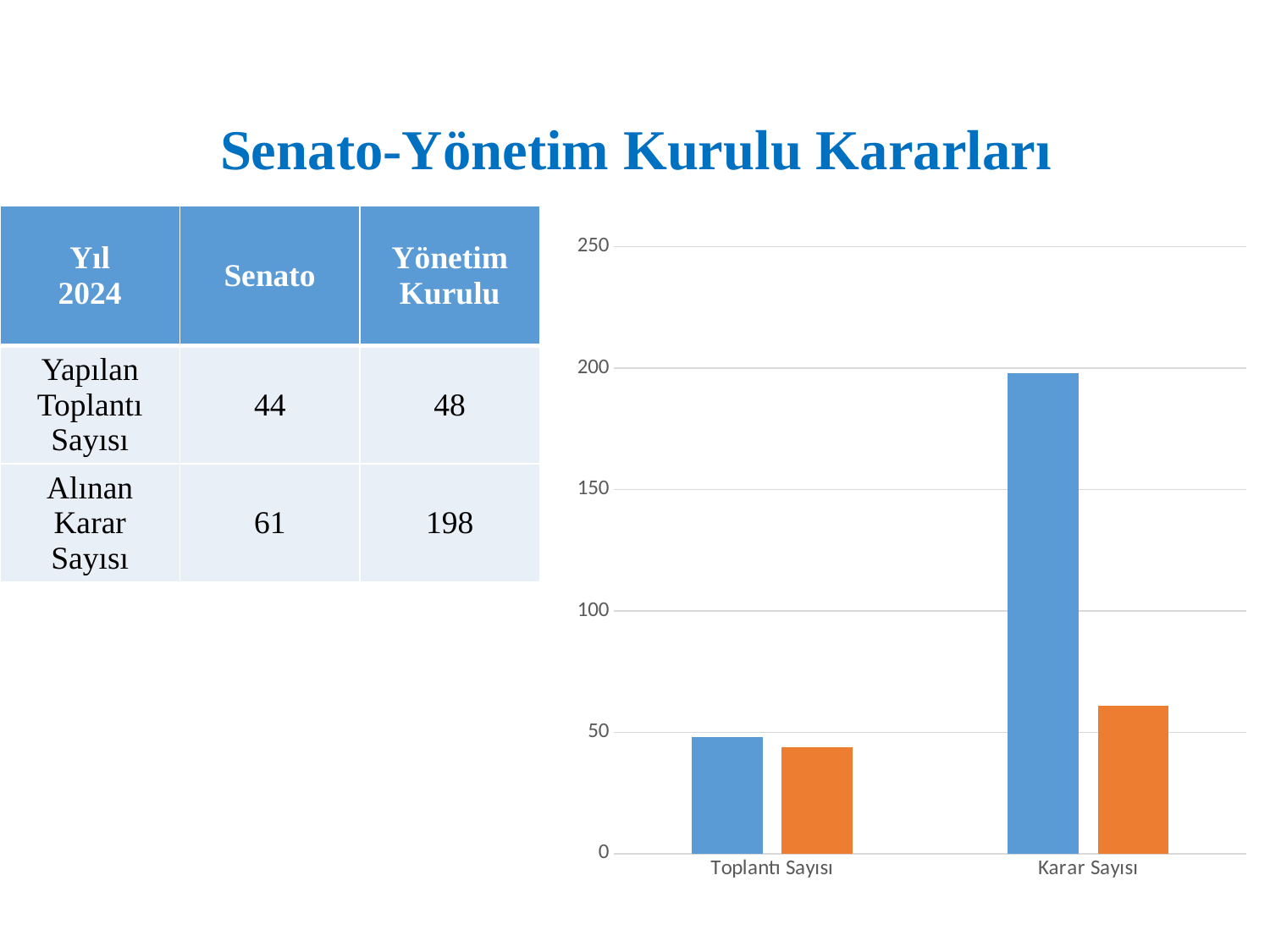
Which category has the tallest bar in the chart? Karar Sayısı How many categories are shown on the x axis of the chart? 2 How many bars are plotted in the chart in total? 4 Is the value of the orange bar for Karar Sayısı greater or less than 50? greater Is the value of the blue bar for Toplantı Sayısı greater or less than 100? less What are the two category labels on the x axis of the chart? Toplantı Sayısı and Karar Sayısı What two colours are used for the bars in the chart? blue and orange For Karar Sayısı, which bar is taller, the blue one or the orange one? the blue one Is the value of the blue bar for Karar Sayısı greater or less than 150? greater What kind of chart is shown on the slide? bar chart Is the blue bar for Karar Sayısı taller or shorter than the blue bar for Toplantı Sayısı? taller